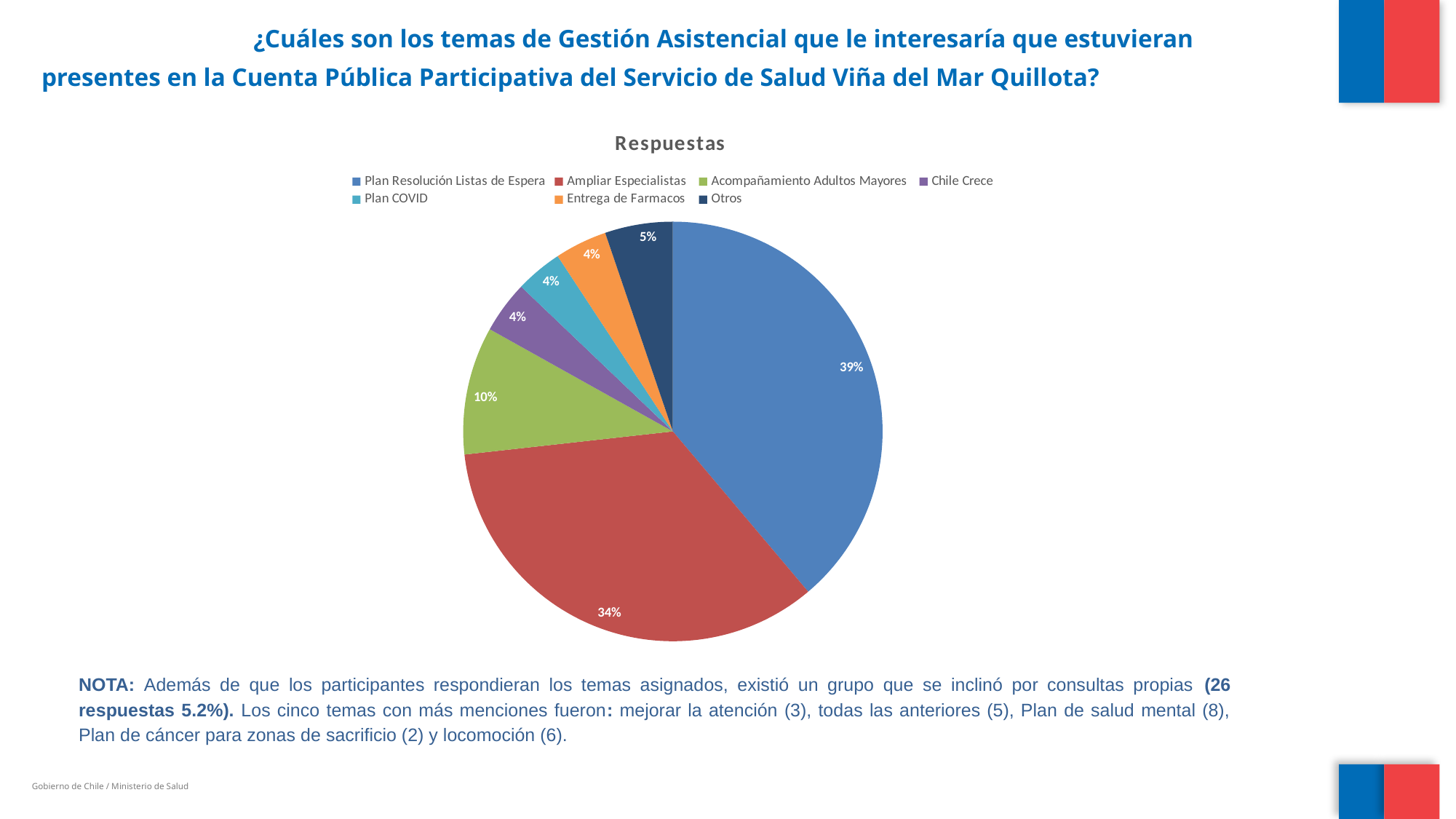
What kind of chart is shown on the slide? Pie chart What is the title of the chart? Respuestas What share of the pie does Otros have? 5% What share of the pie does Acompañamiento Adultos Mayores have? 10% What colour is the slice for Entrega de Farmacos? Orange Which has a larger share, Acompañamiento Adultos Mayores or Otros? Acompañamiento Adultos Mayores How many categories does the legend of the pie chart list? 7 What share of the pie does Chile Crece have? 4% Which category has the largest share of the pie? Plan Resolución Listas de Espera What is the difference in percentage points between Plan Resolución Listas de Espera and Ampliar Especialistas? 5